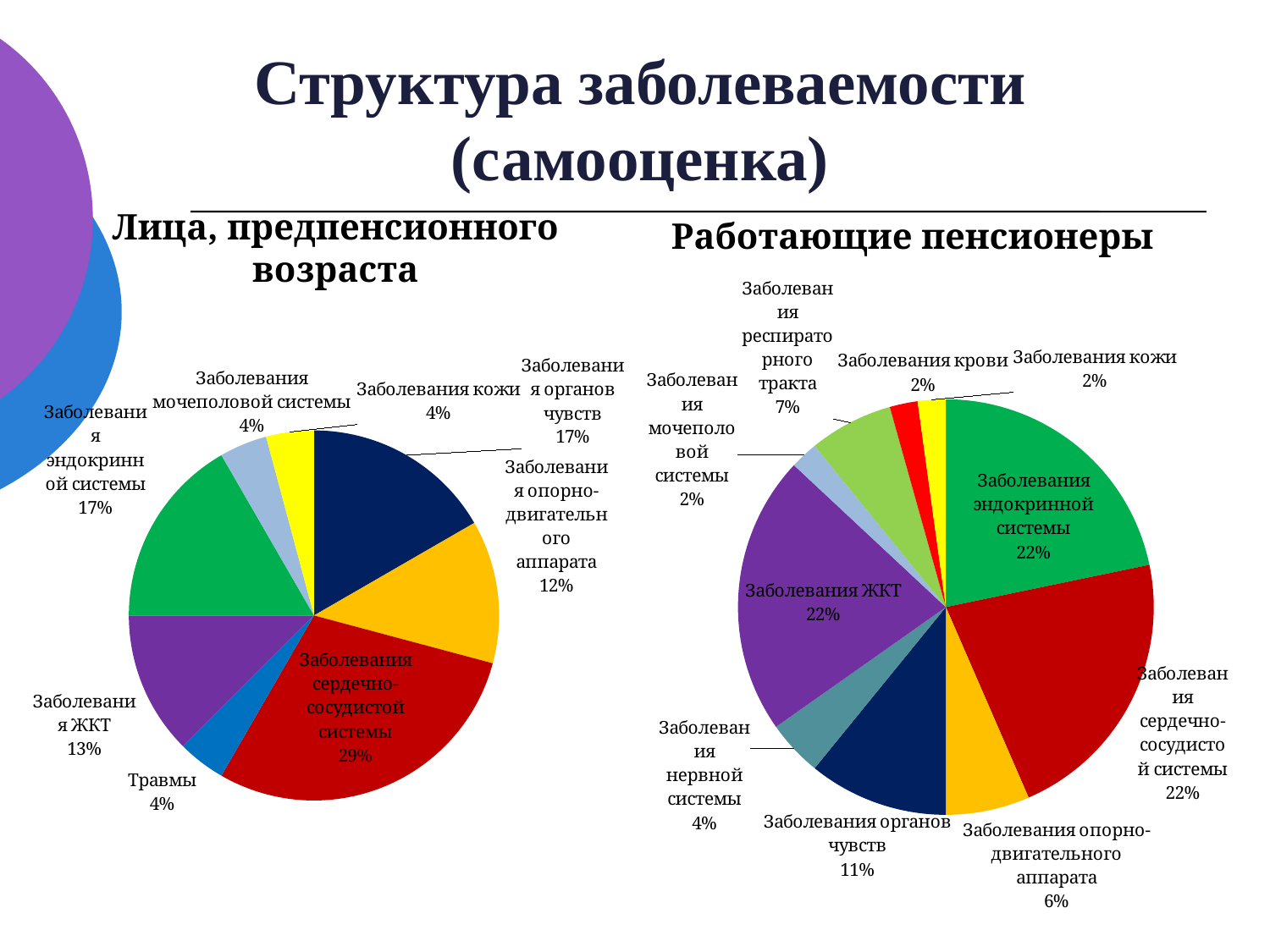
In the 'Лица, предпенсионного возраста' chart, how many slices does the pie have? 8 In the 'Работающие пенсионеры' chart, what is the difference between 'Заболевания ЖКТ' and 'Заболевания органов чувств'? 11% In the 'Работающие пенсионеры' chart, what is the value for 'Заболевания органов чувств'? 11% In the 'Работающие пенсионеры' chart, what is the value for 'Заболевания респираторного тракта'? 7% What type of chart is used on the slide for 'Лица, предпенсионного возраста'? Pie chart In the 'Работающие пенсионеры' chart, how many slices does the pie have? 10 In the 'Лица, предпенсионного возраста' chart, what is the value for 'Заболевания ЖКТ'? 13% In the 'Лица, предпенсионного возраста' chart, what share is 'Заболевания сердечно-сосудистой системы'? 29% In the 'Лица, предпенсионного возраста' chart, which category has the largest slice? Заболевания сердечно-сосудистой системы In the 'Лица, предпенсионного возраста' chart, what is the difference between 'Заболевания органов чувств' and 'Заболевания опорно-двигательного аппарата'? 5% In the 'Работающие пенсионеры' chart, which is larger: 'Заболевания опорно-двигательного аппарата' or 'Заболевания нервной системы'? Заболевания опорно-двигательного аппарата What is the main title of the slide? Структура заболеваемости (самооценка)